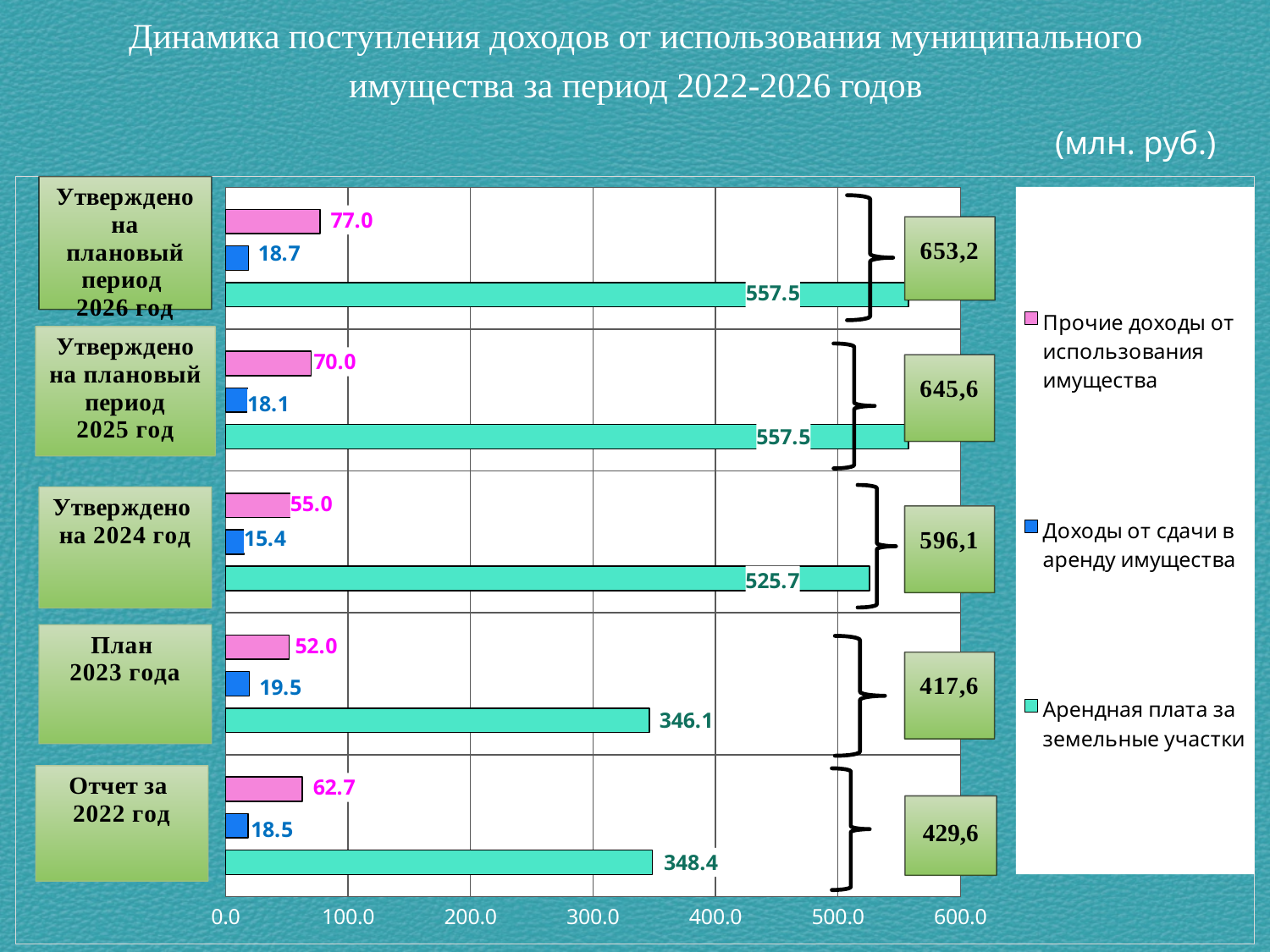
What is the value of «Доходы от сдачи в аренду имущества» for «План 2023 года»? 19.5 What is the value of «Арендная плата за земельные участки» for «Отчет за 2022 год»? 348.4 Which period has the highest value for «Прочие доходы от использования имущества»? Утверждено на плановый период 2026 год Is the value of «Арендная плата за земельные участки» for «Утверждено на 2024 год» greater or less than 500.0? greater What is the total income shown for «Утверждено на 2024 год»? 596,1 How many periods (categories) are shown on the chart? 5 Which period has the lowest value for «Доходы от сдачи в аренду имущества»? Утверждено на 2024 год What kind of chart is shown on the slide? bar chart What is the value of «Прочие доходы от использования имущества» for «Утверждено на плановый период 2026 год»? 77.0 Which is larger for «Прочие доходы от использования имущества»: «Отчет за 2022 год» or «Утверждено на 2024 год»? Отчет за 2022 год How many series does the legend list? 3 What is the difference in «Арендная плата за земельные участки» between «Утверждено на плановый период 2026 год» and «План 2023 года»? 211.4